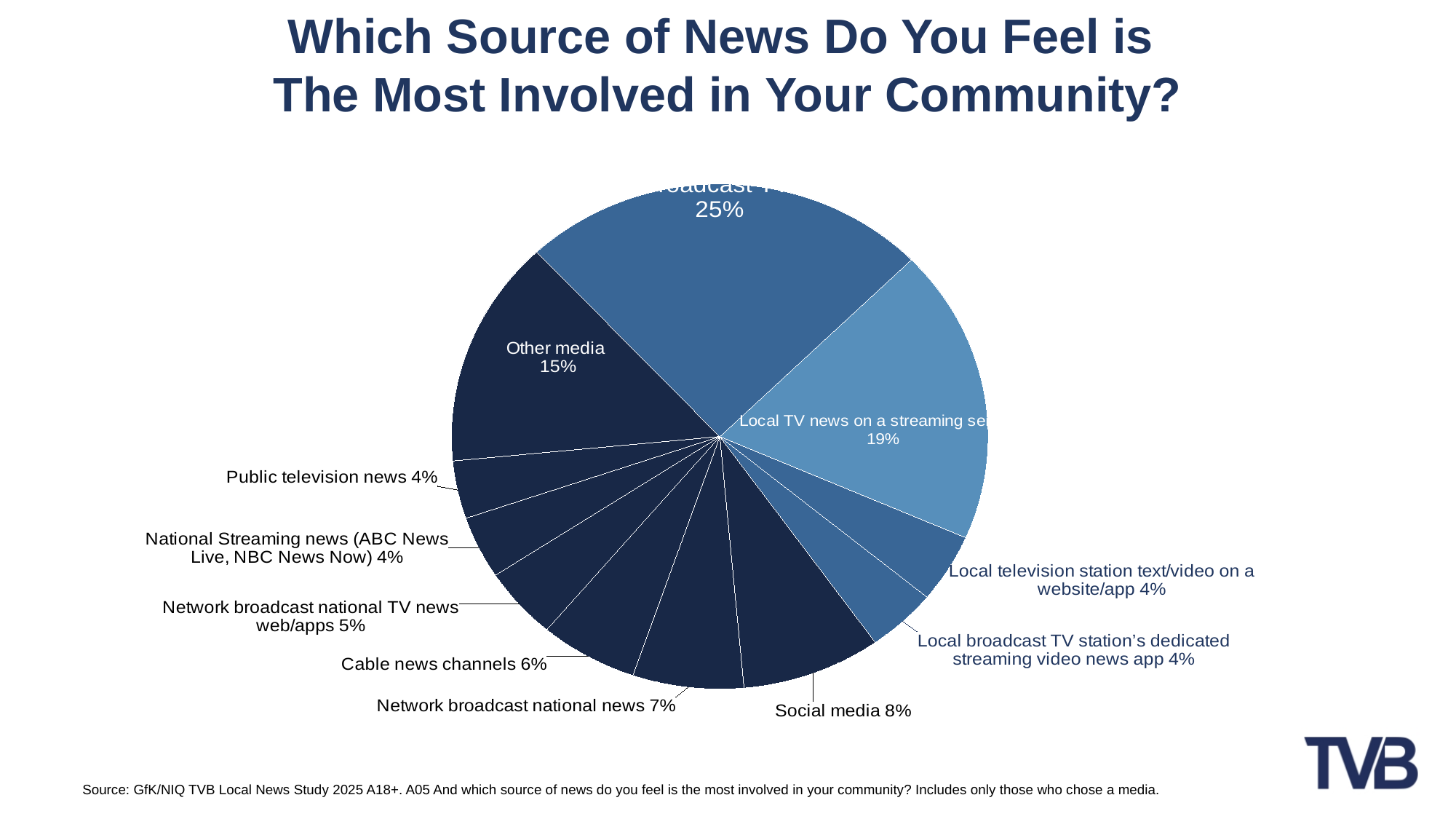
Which is larger, Other media or Network broadcast national news? Other media What is the difference in percentage points between Other media and Social media? 7 What is the value for Local television station text/video on a website/app? 4% What is the value for Social media? 8% What is the value for Network broadcast national TV news web/apps? 5% Which is larger, Social media or Cable news channels? Social media What is the value for Public television news? 4% What share of the pie does Other media account for? 15% What is the value for Cable news channels? 6% What kind of chart is shown on the slide? pie chart What is the value for Network broadcast national news? 7% What is the title of the chart? Which Source of News Do You Feel is The Most Involved in Your Community?